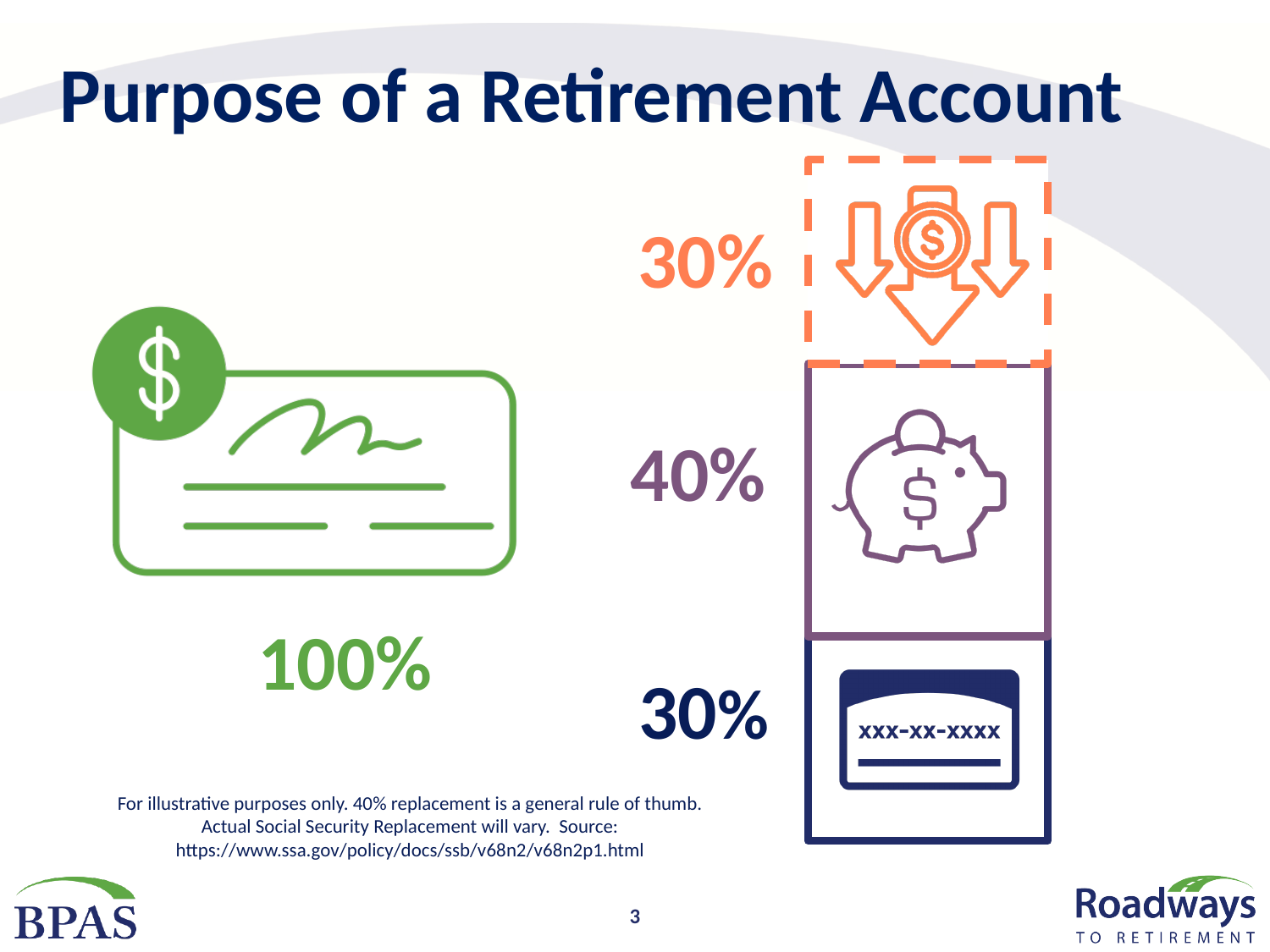
What percentage is shown for the bottom (dark blue, xxx-xx-xxxx card) segment of the stacked bar? 30% What is the total of the three segments in the stacked bar on the right? 100% Is the middle segment's value larger or smaller than the top segment's value? larger Which segment of the stacked bar has the largest percentage? The middle (piggy bank) segment, 40% What percentage is shown for the middle (purple, piggy bank) segment of the stacked bar? 40% What percentage is shown for the top (orange, dashed) segment of the stacked bar? 30% What is the difference between the middle segment (40%) and the bottom segment (30%)? 10% What colour is the top segment of the stacked bar? Orange What is the title of the slide? Purpose of a Retirement Account How many segments make up the stacked bar on the right side of the slide? 3 What percentage is shown beneath the green check graphic on the left? 100%